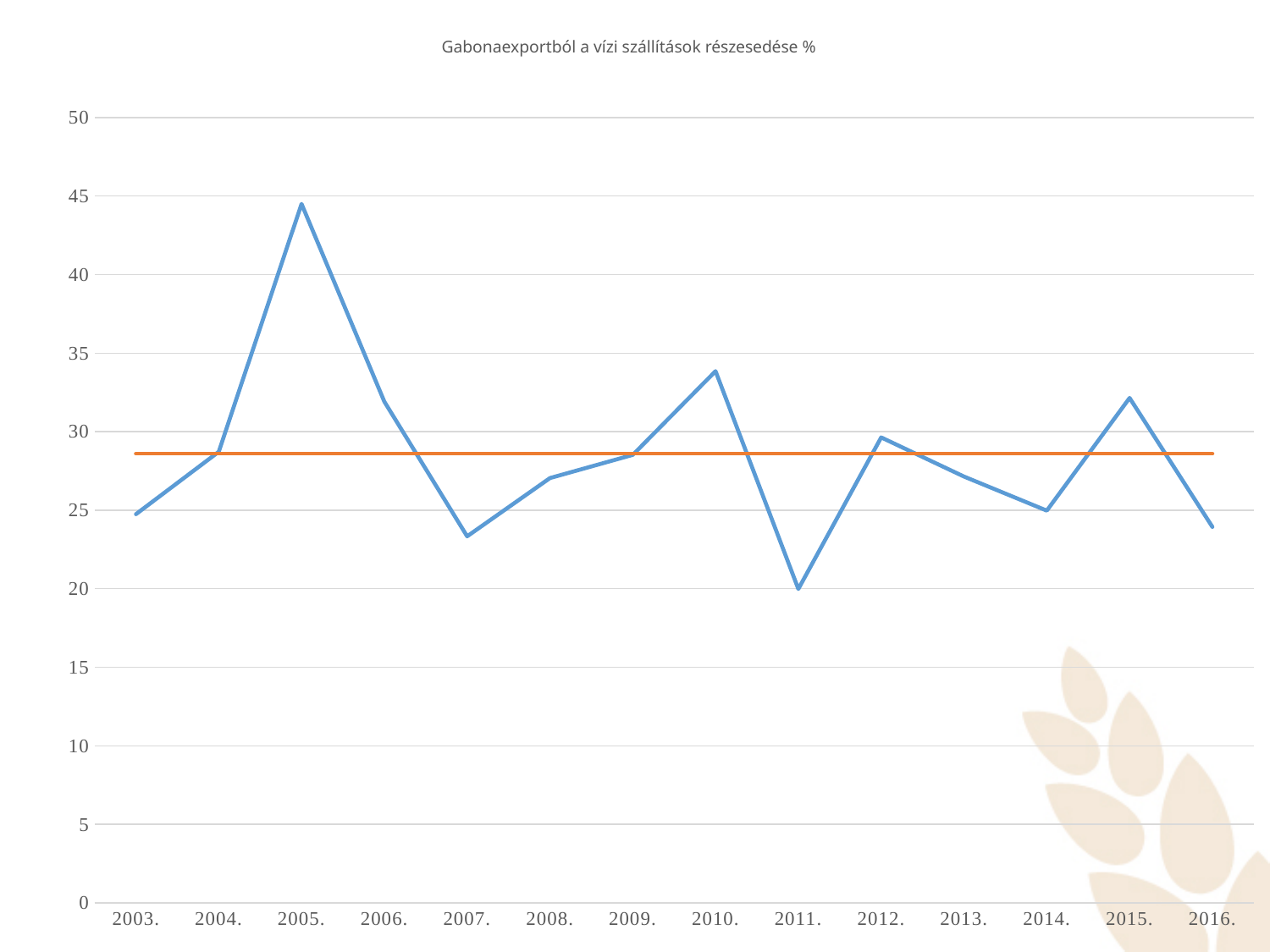
What is the title of the chart? Gabonaexportból a vízi szállítások részesedése % In which year does the blue line reach its highest value? 2005. Is the value for 2007 greater or less than 25? less Is the value for 2016 greater or less than 25? less Which year has the higher value, 2007 or 2015? 2015. What kind of chart is shown on the slide? line chart Which year has the higher value, 2005 or 2010? 2005. Is the value for 2005 greater or less than 40? greater How many years are plotted along the x axis? 14 In which year does the blue line reach its lowest value? 2011. Does the blue line rise or fall from 2005 to 2007? fall